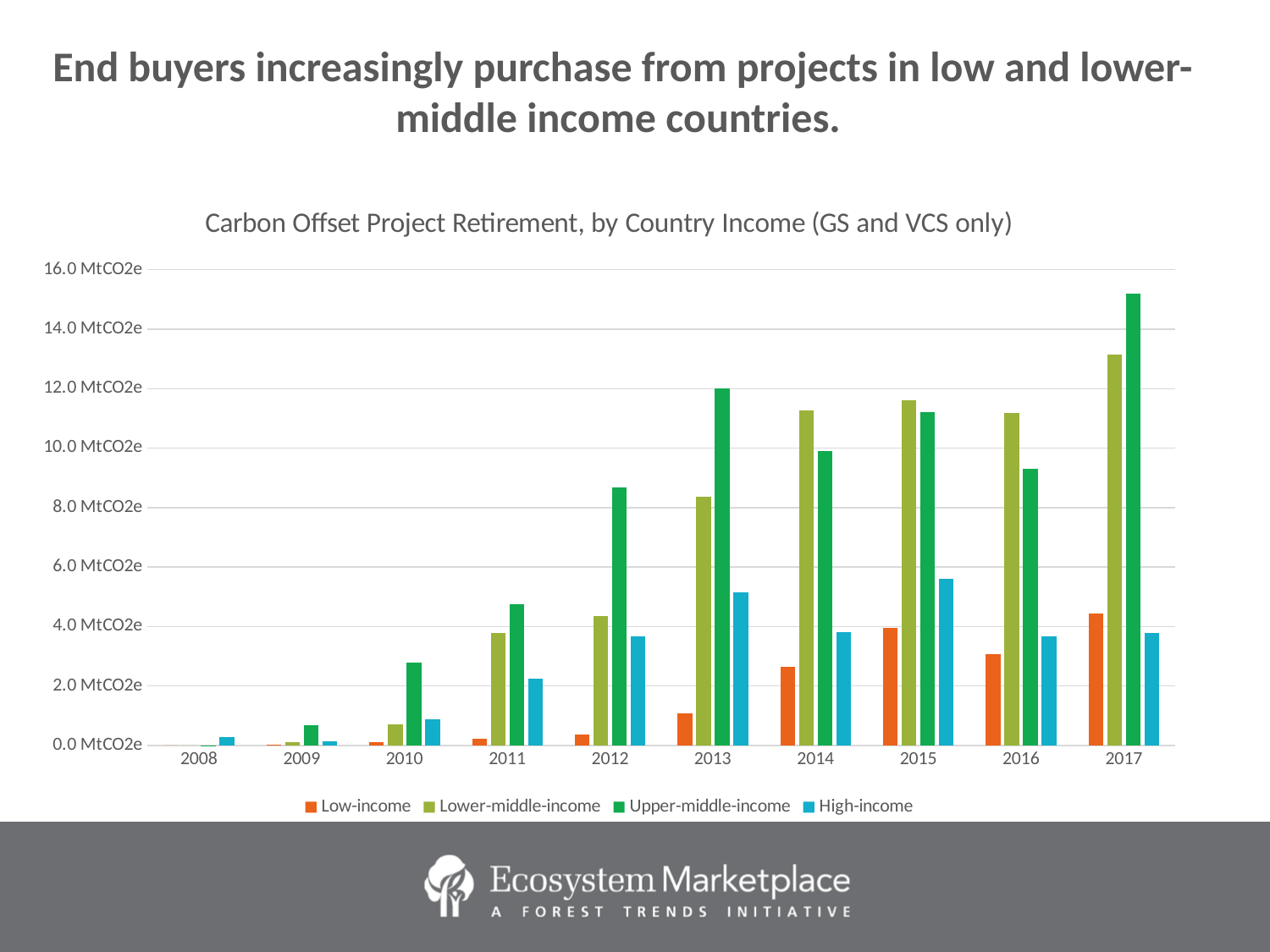
How many series does the legend list? 4 In 2014, which is larger: the Lower-middle-income value or the Upper-middle-income value? Lower-middle-income Which series has the lowest value in 2013? Low-income Is the Upper-middle-income value for 2017 greater or less than 14.0 MtCO2e? greater What kind of chart is shown on the slide? Bar chart Is the High-income value for 2013 greater or less than 4.0 MtCO2e? greater What is the title of the chart? Carbon Offset Project Retirement, by Country Income (GS and VCS only) How many years are shown along the x axis? 10 In 2013, which is larger: the Upper-middle-income value or the Lower-middle-income value? Upper-middle-income Do the Low-income values generally rise or fall from 2008 to 2017? rise In which year is the Upper-middle-income bar the highest? 2017 Is the Lower-middle-income value for 2017 greater or less than 12.0 MtCO2e? greater